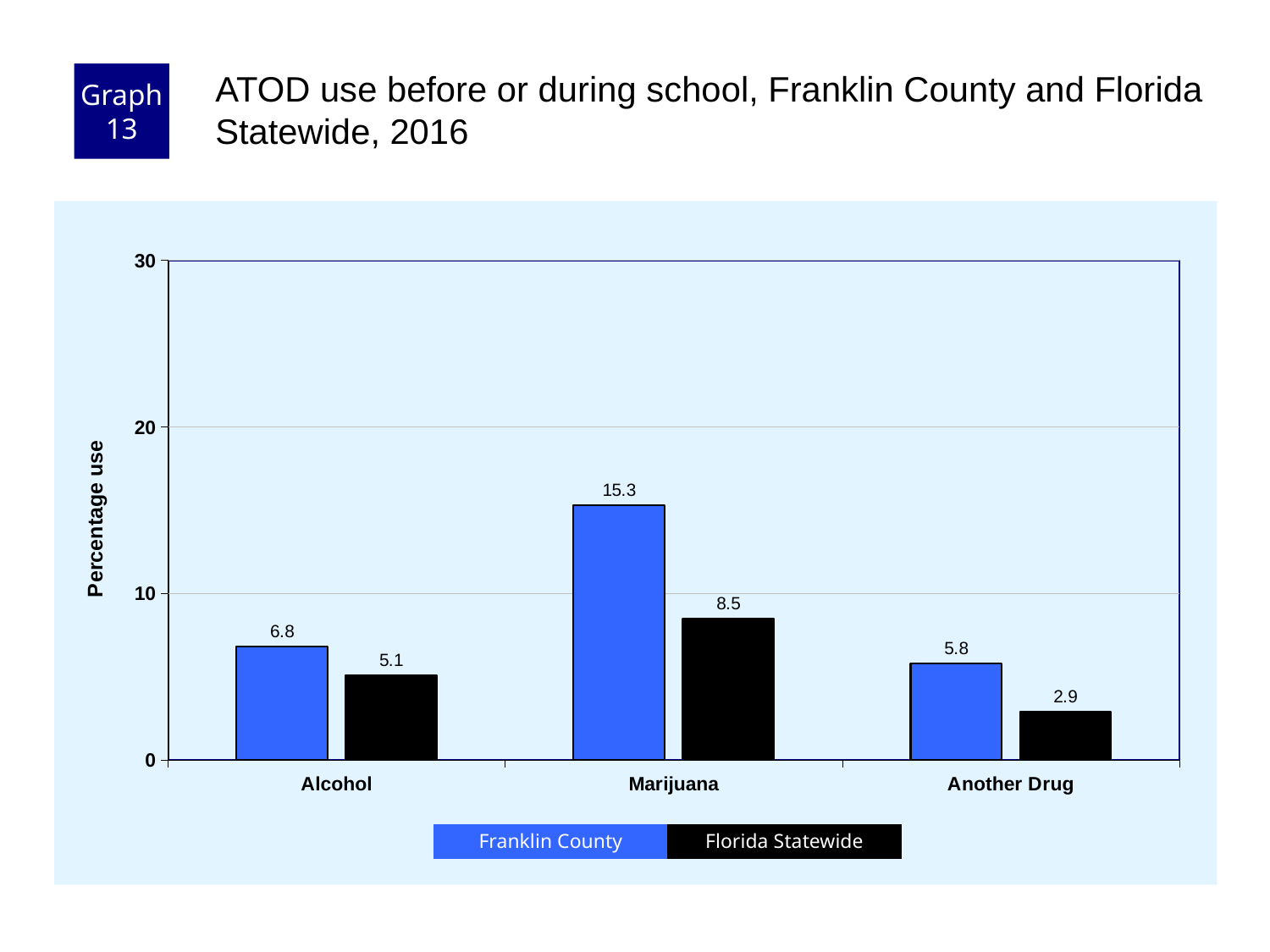
What kind of chart is shown on the slide? bar chart What is the Florida Statewide value for Alcohol? 5.1 How many categories are shown on the x axis? 3 What is the difference between the Franklin County and Florida Statewide values for Marijuana? 6.8 Which category has the highest Franklin County value? Marijuana What is the Florida Statewide value for Another Drug? 2.9 Which is larger for Alcohol: the Franklin County value or the Florida Statewide value? Franklin County Which category has the lowest Florida Statewide value? Another Drug What is the difference between the Franklin County values for Alcohol and Another Drug? 1.0 What is the Franklin County value for Marijuana? 15.3 How many series does the legend list? 2 Is the Franklin County value for Marijuana greater or less than 10? greater